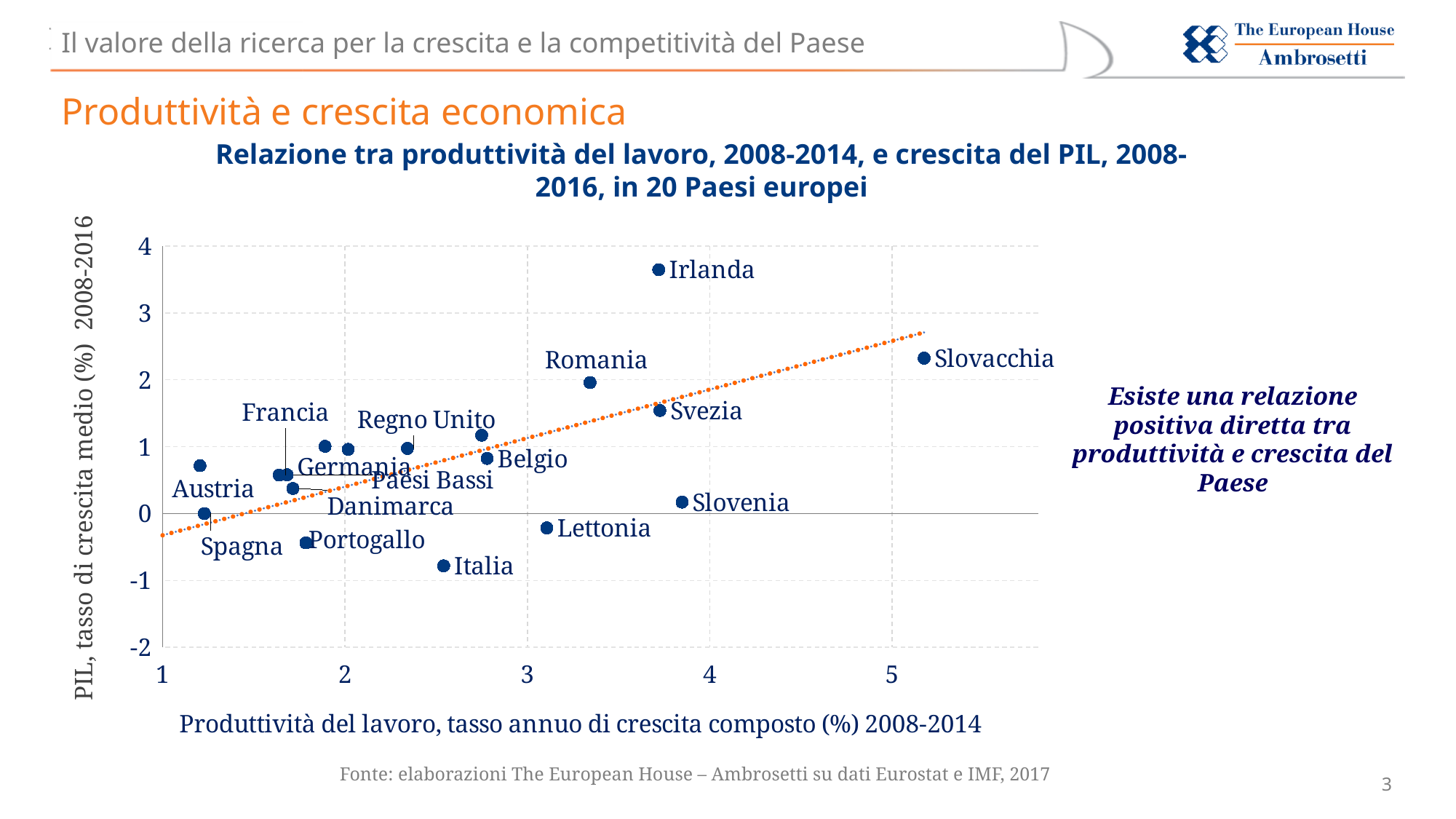
Is the GDP growth value for Irlanda greater or less than 3? greater Which country has the lowest GDP growth rate (y-axis value) in the chart? Italia Is the GDP growth value for Italia greater or less than 0? less Which has a higher GDP growth rate, Italia or Portogallo? Portogallo Which country has the highest GDP growth rate (y-axis value) in the chart? Irlanda Is the GDP growth value for Svezia greater or less than 1? greater According to the dotted trend line, does GDP growth rise or fall as labour productivity increases? Rises Which country has the highest labour productivity growth (x-axis value) in the chart? Slovacchia What is the label of the x axis of the chart? Produttività del lavoro, tasso annuo di crescita composto (%) 2008-2014 What kind of chart is shown on the slide? Scatter chart Which has a higher GDP growth rate, Romania or Svezia? Romania